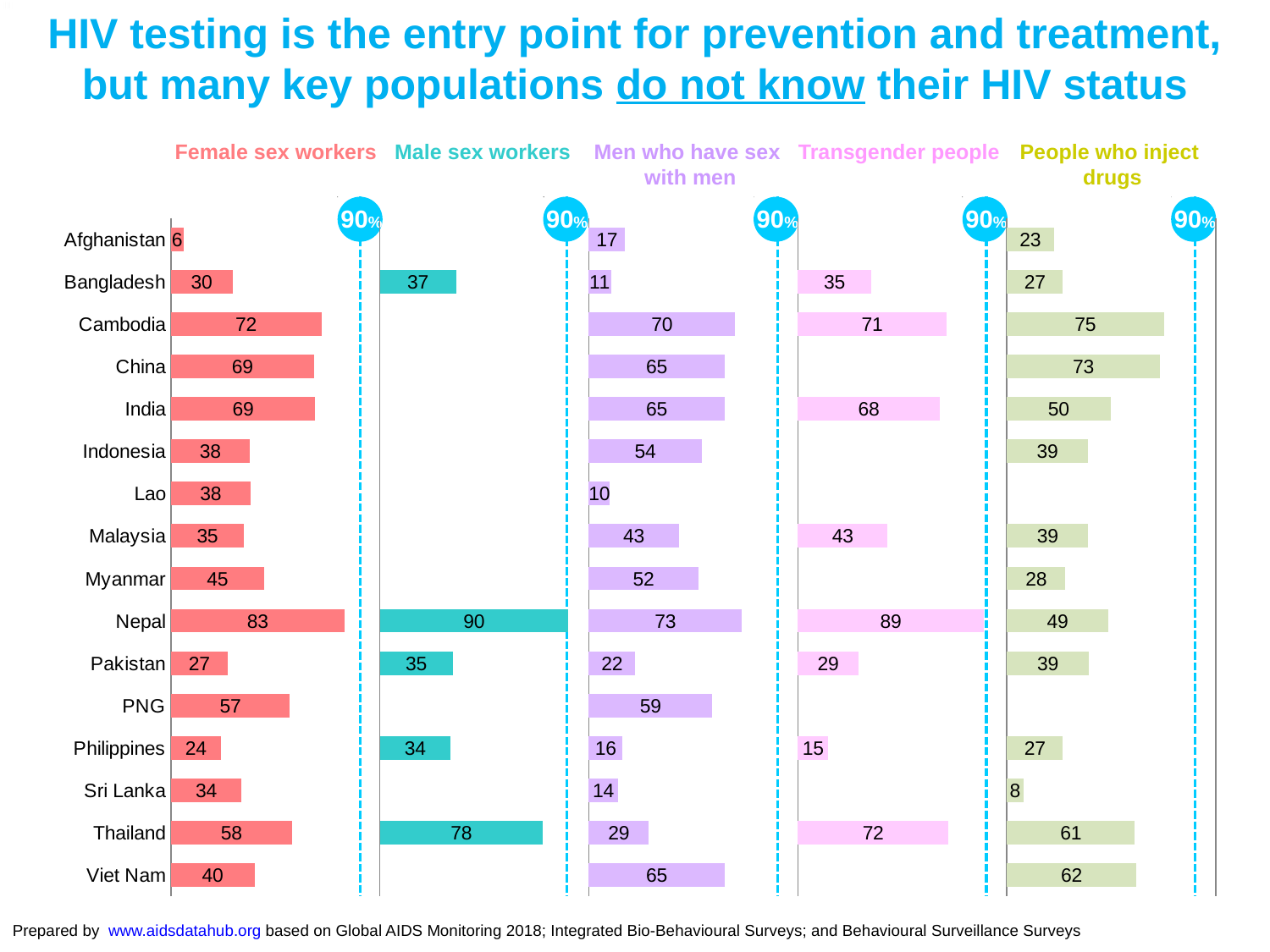
In the Male sex workers chart, what is the value for Thailand? 78 How many countries have a bar in the Transgender people chart? 8 What kind of chart is used on this slide? Bar chart How many countries have a bar in the Male sex workers chart? 5 What target value is marked by the dashed vertical line in each chart? 90% In the People who inject drugs chart, which is larger, the value for Thailand or the value for India? Thailand In the Men who have sex with men chart, what is the value for Lao? 10 In the Men who have sex with men chart, what is the value for Indonesia? 54 In the Female sex workers chart, what is the difference between the values for Cambodia and Bangladesh? 42 In the Female sex workers chart, what is the value for Nepal? 83 In the People who inject drugs chart, which country has the lowest value? Sri Lanka In the Transgender people chart, which country has the highest value? Nepal